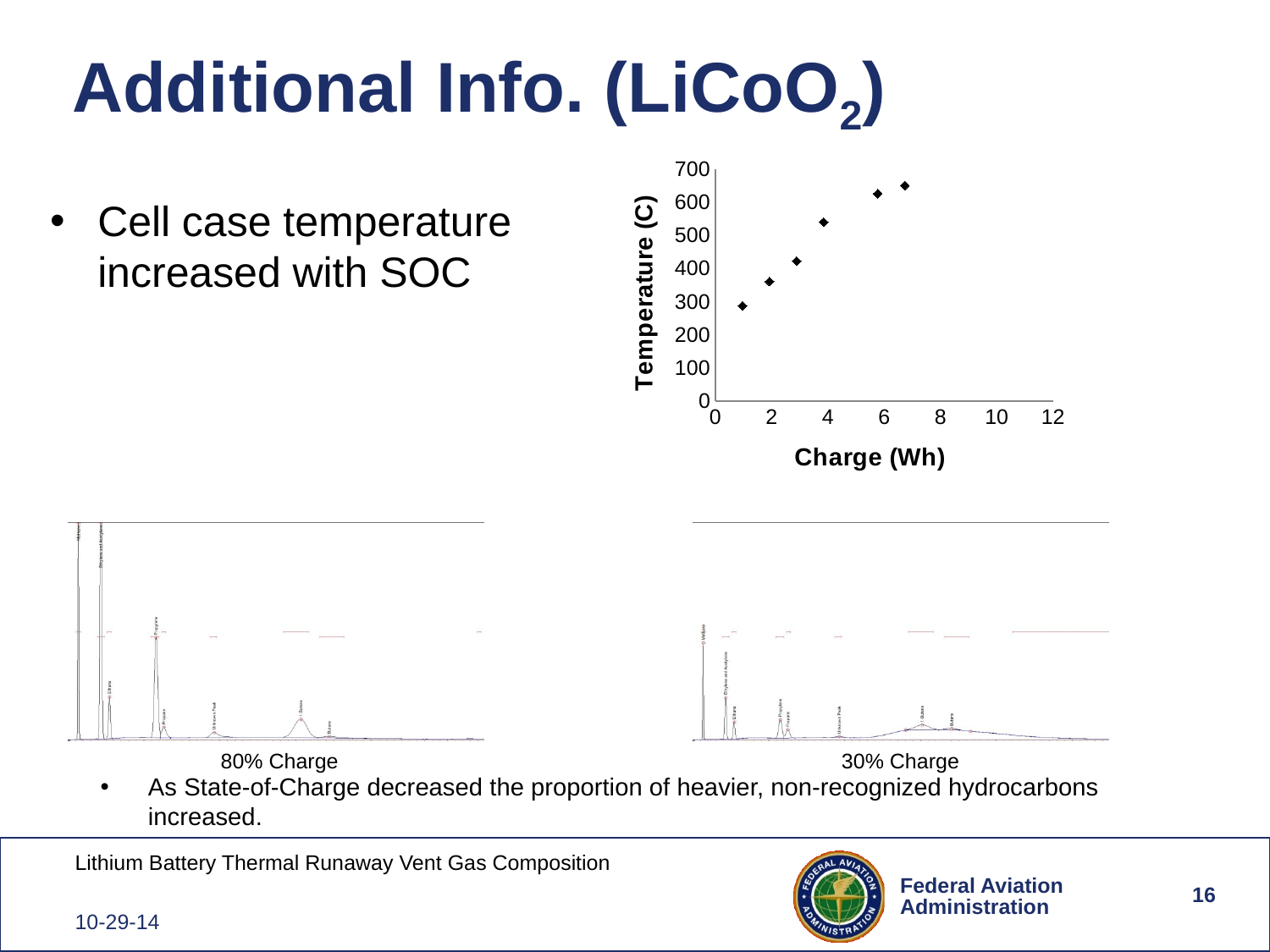
In the Temperature vs Charge chart, is the temperature of the point at about 4 Wh greater or less than 500? greater In the Temperature vs Charge chart, do the temperature values rise or fall as Charge (Wh) increases? rise What is the title of the x axis of the scatter chart in the upper right? Charge (Wh) In the Temperature vs Charge chart, is the temperature of the rightmost point greater or less than 600? greater In the Temperature vs Charge chart, which point has the highest temperature, the leftmost or the rightmost? rightmost What is the title of the y axis of the scatter chart in the upper right? Temperature (C) In the Temperature vs Charge chart, which point has the lowest temperature, the leftmost or the rightmost? leftmost What kind of chart is the chart in the upper right of the slide? scatter chart In the Temperature vs Charge chart, is the temperature of the point at about 2 Wh greater or less than 300? greater In the Temperature vs Charge chart, is the temperature at about 6 Wh larger or smaller than the temperature at about 1 Wh? larger How many data points are plotted in the Temperature vs Charge chart? 6